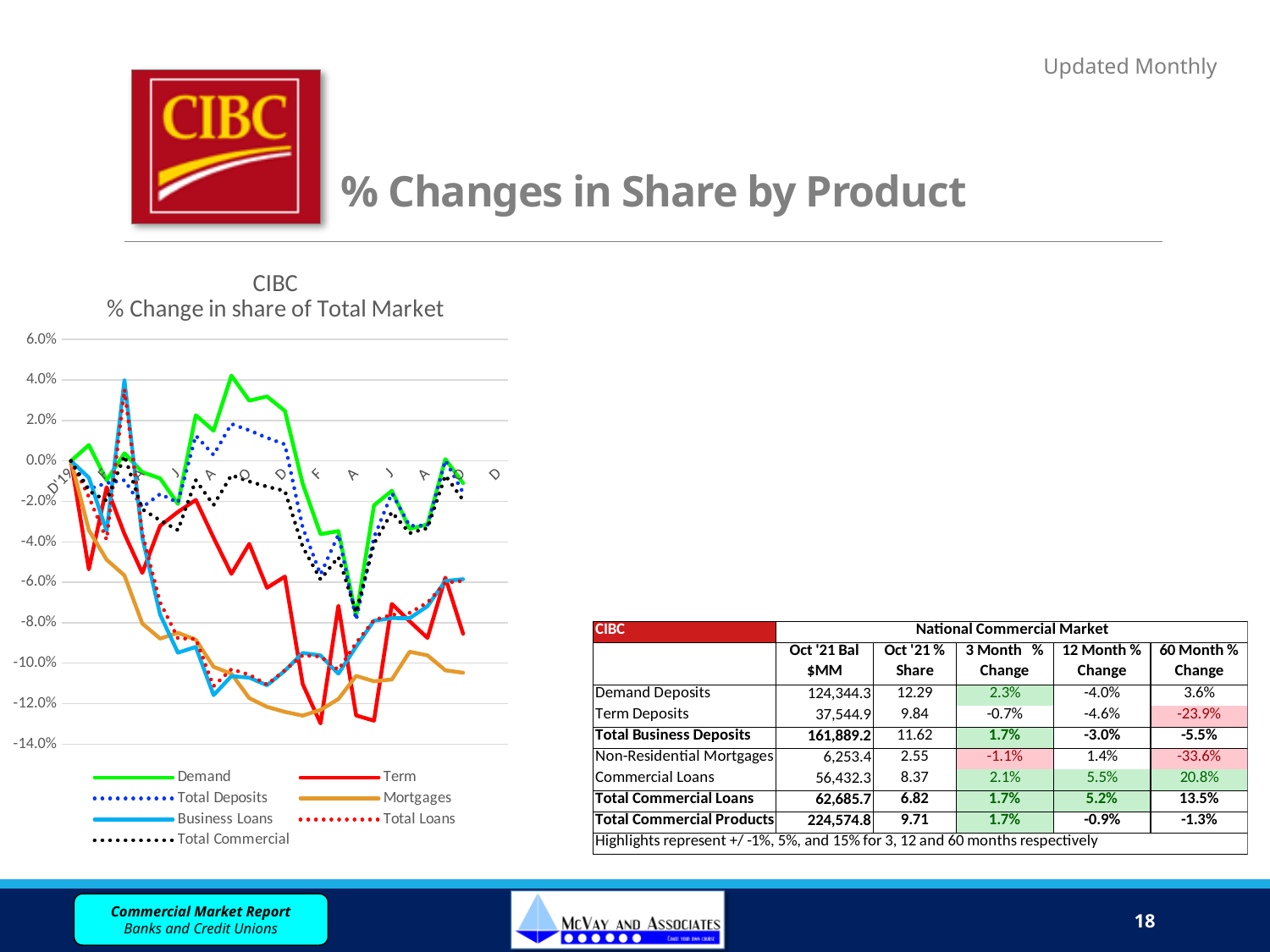
Which series is lowest at the final point on the right of the chart? Mortgages How many series does the chart legend list? 7 Is the highest point of the Demand series greater or less than 2.0%? greater Is the final value of the Business Loans series greater or less than -8.0%? greater Does the Business Loans series overall rise or fall from the start to the end of the x axis? Fall Which colour is used for the Demand series in the chart? Green Is the lowest point of the Term series greater or less than -12.0%? less Does the Mortgages series overall rise or fall from the start to the end of the x axis? Fall What is the title of the chart? CIBC % Change in share of Total Market At the final point on the right of the chart, which is higher: Business Loans or Mortgages? Business Loans What kind of chart is shown on the slide? Line chart